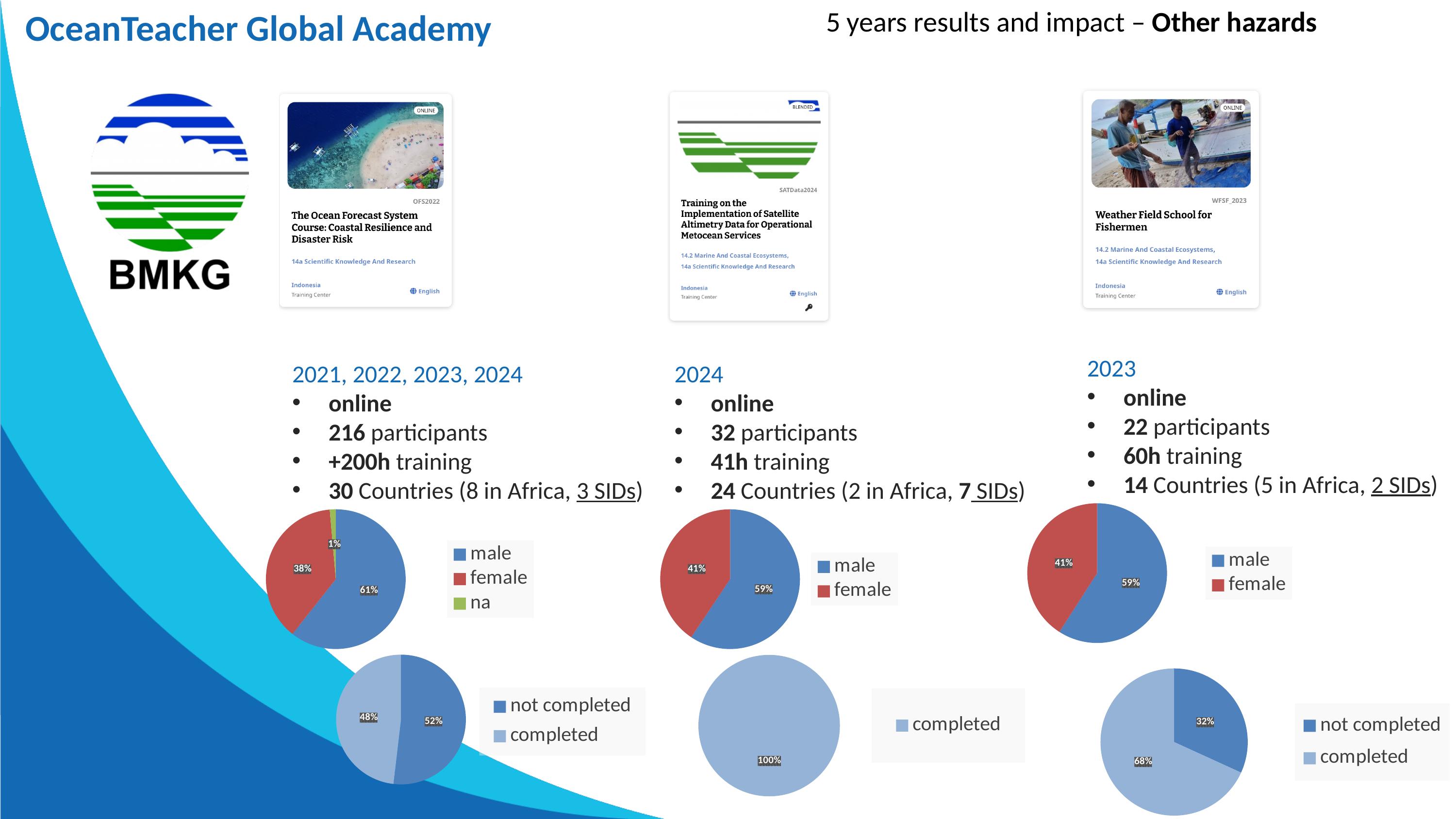
In the bottom-left pie chart (completion for the Ocean Forecast System course), what is the difference between the not completed and completed shares? 4% In the bottom-right pie chart (completion for the Weather Field School for Fishermen), what share is not completed? 32% What type of chart is used for the gender breakdown in the top-right chart (Weather Field School for Fishermen)? pie chart In the top-left pie chart (gender for the Ocean Forecast System course), what share is female? 38% In the bottom-right pie chart (completion for the Weather Field School for Fishermen), what share is completed? 68% In the top-middle pie chart (gender for the Satellite Altimetry training), which is larger, male or female? male In the top-left pie chart (gender for the Ocean Forecast System course), what share is male? 61% How many entries does the legend of the top-left pie chart (gender for the Ocean Forecast System course) list? 3 In the bottom-middle pie chart (completion for the Satellite Altimetry training), what share is completed? 100% In the top-middle pie chart (gender for the Satellite Altimetry training), what share is female? 41% In the bottom-left pie chart (completion for the Ocean Forecast System course), what share is not completed? 52% In the top-left pie chart (gender for the Ocean Forecast System course), which category has the smallest share? na